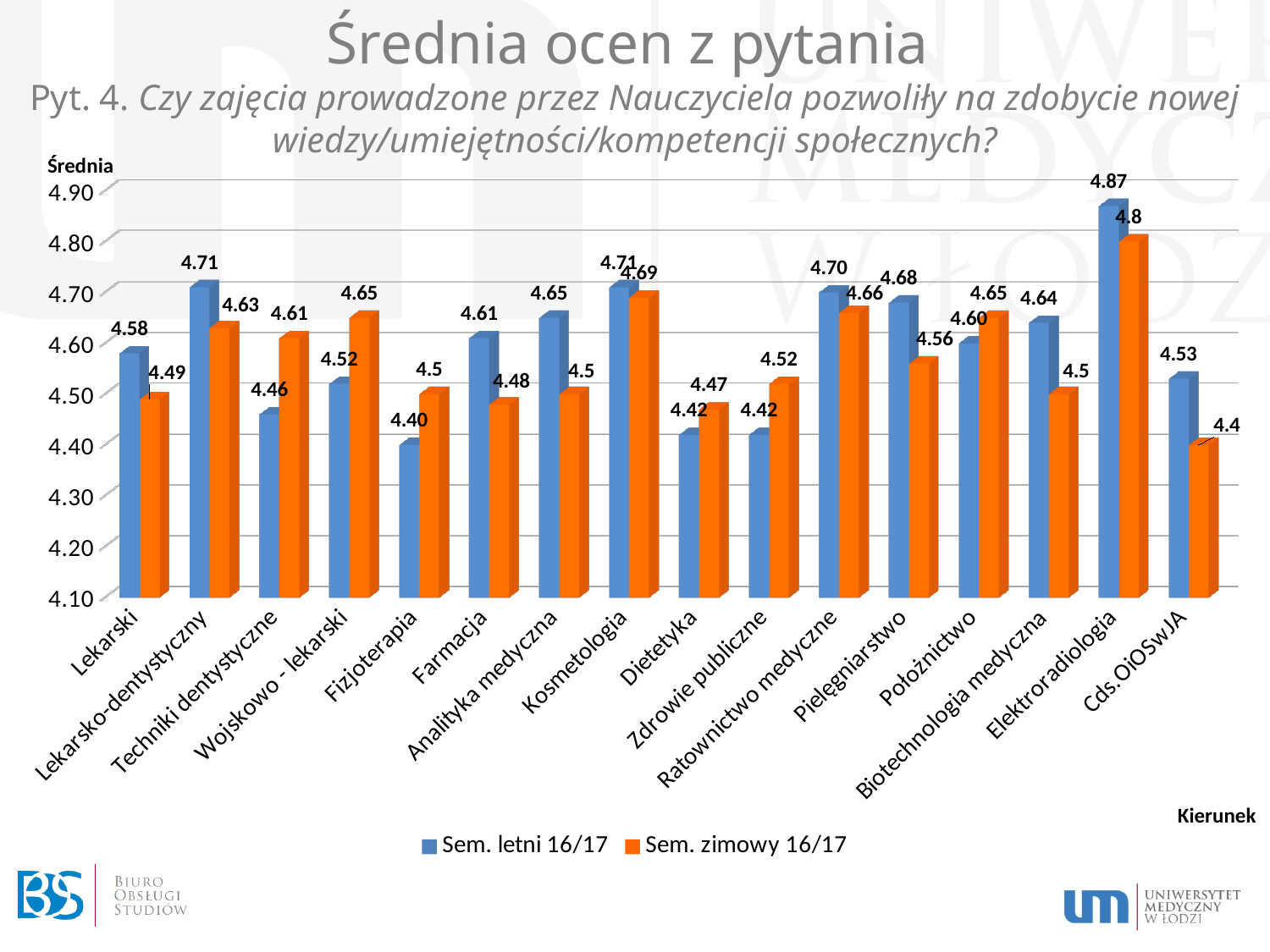
What is the Sem. letni 16/17 value for Elektroradiologia? 4.87 What kind of chart is shown on the slide? bar chart What is the Sem. letni 16/17 value for Fizjoterapia? 4.40 Is the Sem. zimowy 16/17 value for Zdrowie publiczne greater or less than 4.50? greater How many series does the legend list? 2 Which category has the highest Sem. letni 16/17 value? Elektroradiologia Which is larger for Farmacja: the Sem. letni 16/17 value or the Sem. zimowy 16/17 value? Sem. letni 16/17 How many categories (kierunki) are shown on the x axis? 16 What is the label of the vertical axis? Średnia What is the Sem. zimowy 16/17 value for Techniki dentystyczne? 4.61 Which category has the lowest Sem. zimowy 16/17 value? Cds.OiOSwJA What is the difference between the Sem. letni 16/17 and Sem. zimowy 16/17 values for Techniki dentystyczne? 0.15